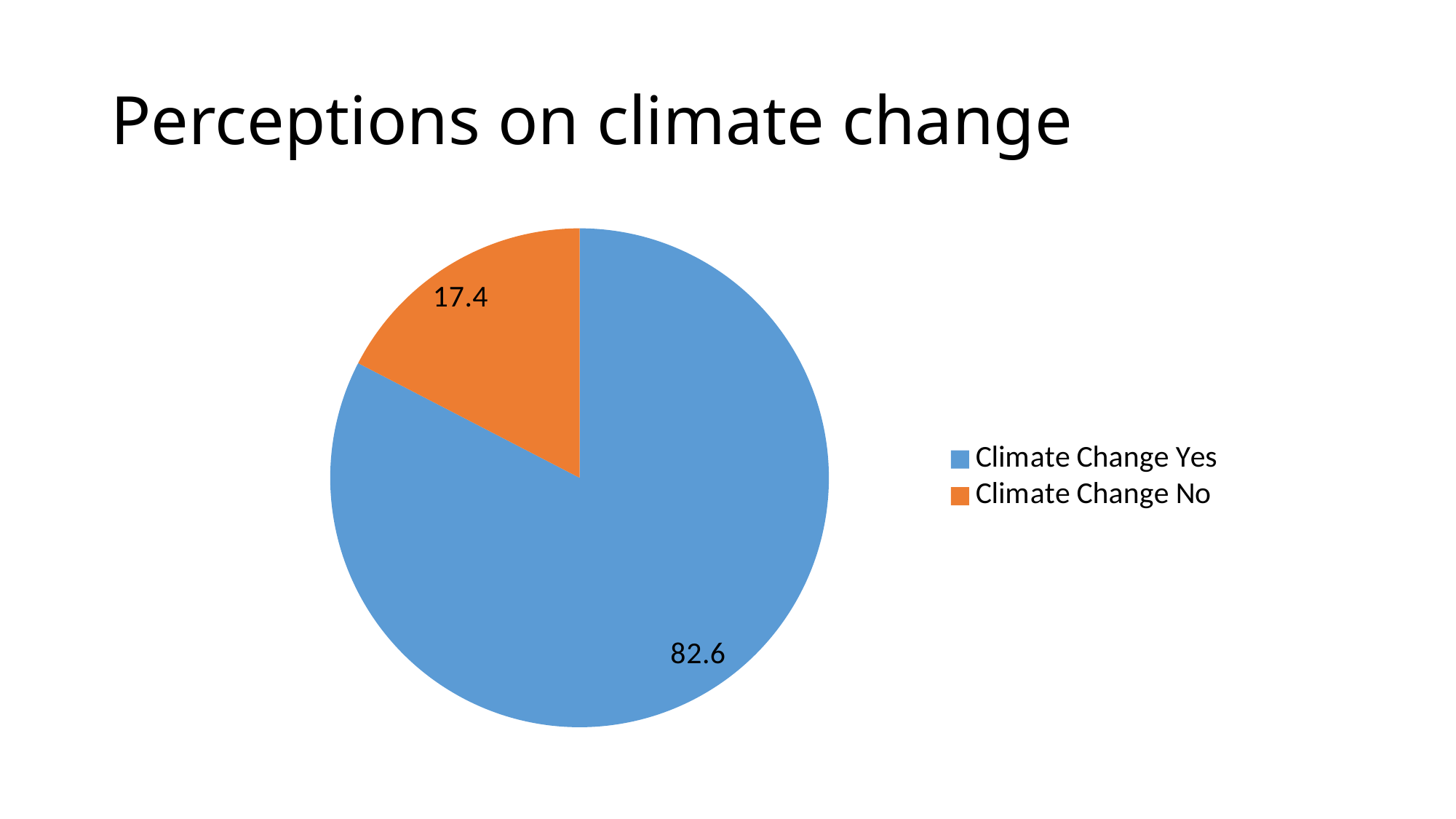
Which is larger, Climate Change Yes or Climate Change No? Climate Change Yes What colour is the Climate Change No slice? orange What is the value for Climate Change No? 17.4 How many slices does the pie chart have? 2 What is the title of the slide containing the chart? Perceptions on climate change What is the total of the two slice values? 100 Which category has the largest slice? Climate Change Yes How many entries does the legend list? 2 What kind of chart is shown on the slide? pie chart Which category has the smallest slice? Climate Change No What is the difference between the values for Climate Change Yes and Climate Change No? 65.2 What is the value for Climate Change Yes? 82.6